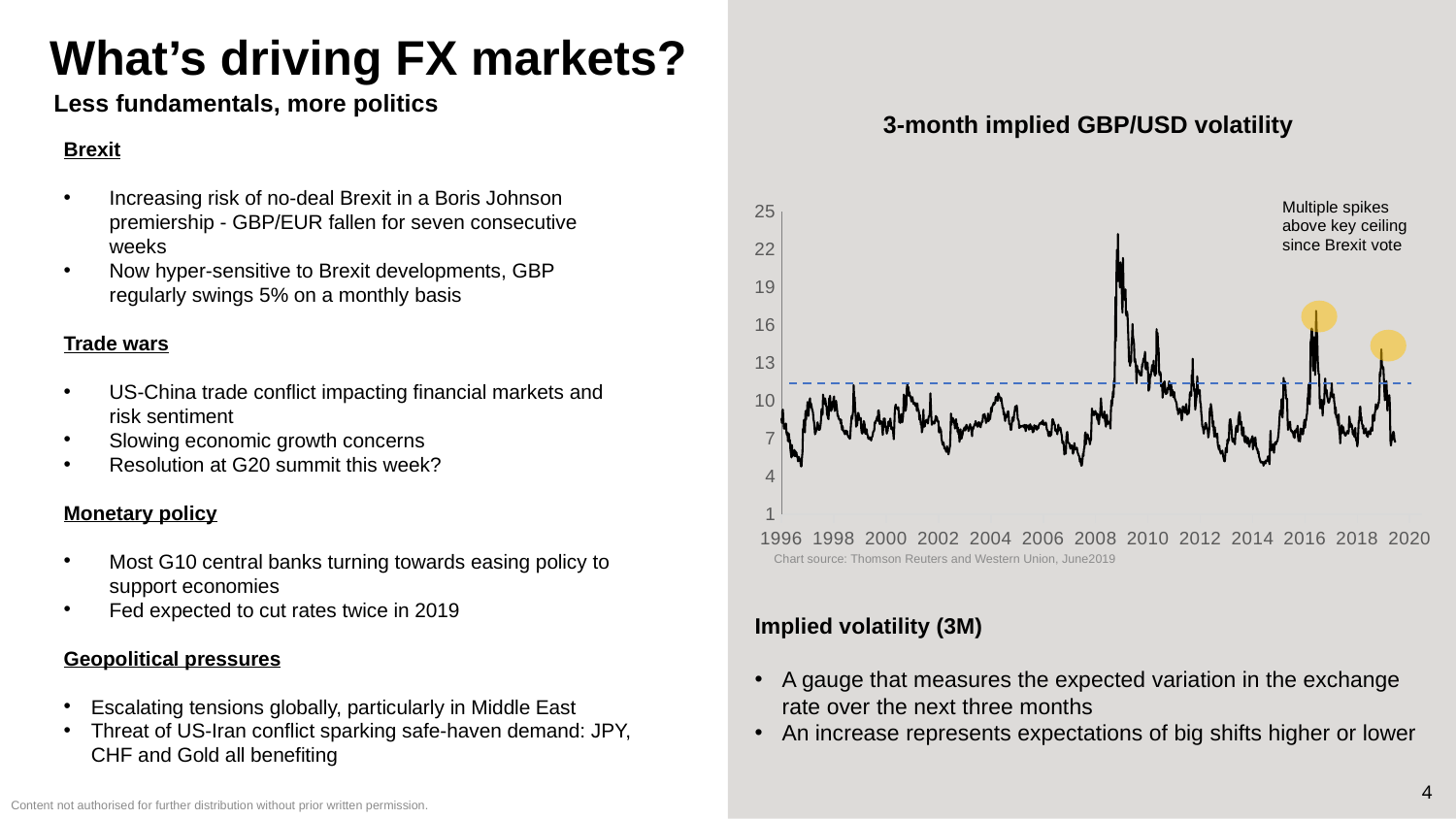
What type of chart is shown on the slide? Line chart What is the first year label on the x axis of the chart? 1996 How many year labels are shown on the x axis of the chart? 13 Is the value of the highlighted spike around 2019 greater or less than 10? greater Does the highest peak of the volatility line occur before or after 2010? before What does the annotation in the top right of the chart say? Multiple spikes above key ceiling since Brexit vote What is the highest value shown on the y axis of the chart? 25 What is the title of the chart on the slide? 3-month implied GBP/USD volatility Is the volatility value around 2014 greater or less than 10? less Is the value of the highlighted spike around 2016 greater or less than 13? greater